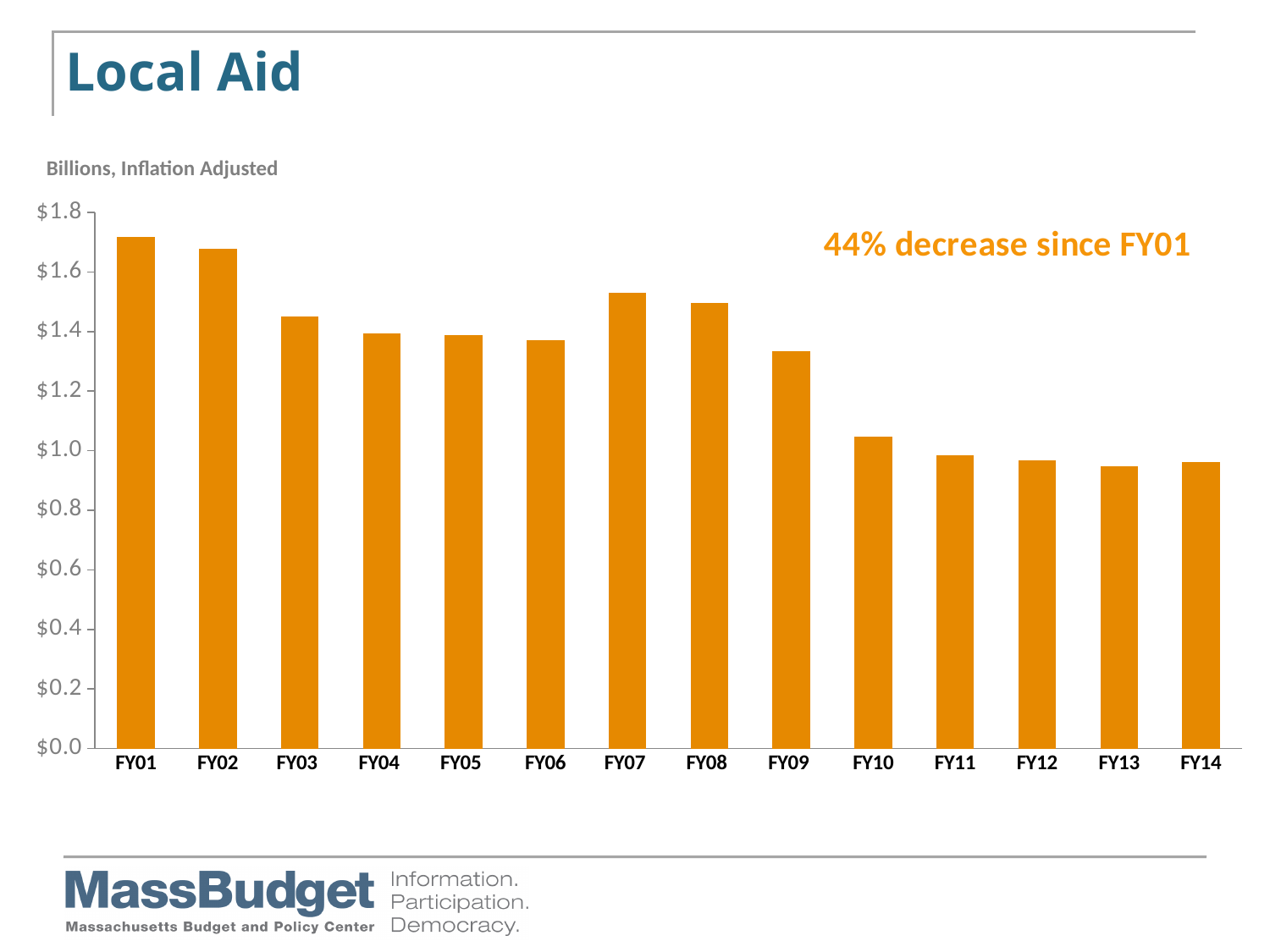
Which fiscal year has the highest value on the chart? FY01 How many fiscal years are plotted on the chart? 14 Which is larger, the value for FY09 or the value for FY10? FY09 What kind of chart is shown on the slide? Bar chart Which is larger, the value for FY01 or the value for FY14? FY01 Overall, do the values rise or fall from FY01 to FY14? Fall Is the value for FY09 greater or less than $1.2? greater Which is larger, the value for FY07 or the value for FY06? FY07 What percentage decrease since FY01 does the annotation on the chart state? 44% Is the value for FY07 greater or less than $1.4? greater Is the value for FY11 greater or less than $1.0? less